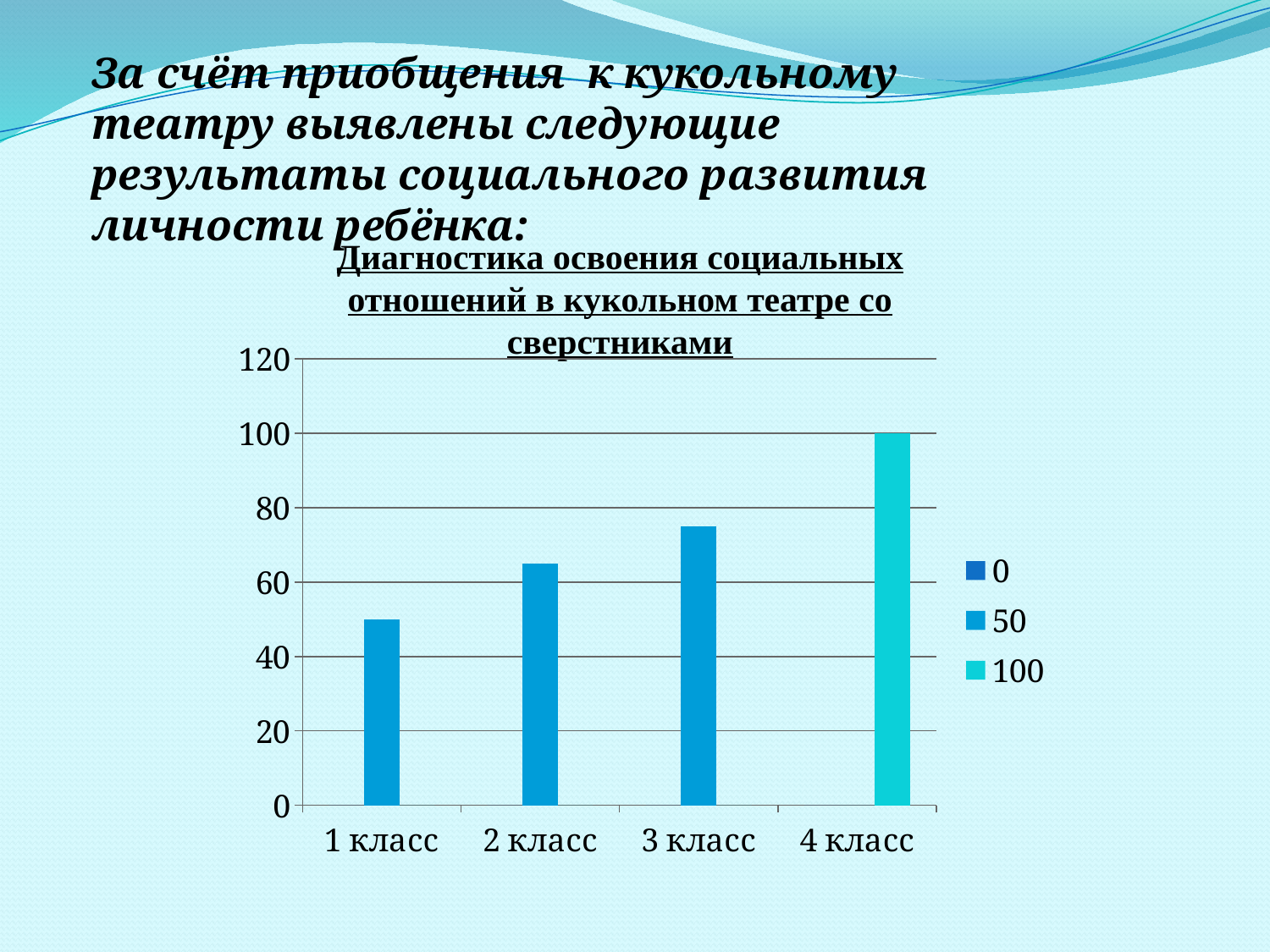
Is the value for 3 класс greater or less than 60? greater Is the value for 1 класс greater or less than 60? less Which category has the lowest bar in the chart? 1 класс How many entries does the chart's legend list? 3 Which has the larger value, 2 класс or 3 класс? 3 класс Is the value for 2 класс greater or less than 80? less Which category has the highest bar in the chart? 4 класс What is the value for 4 класс in the chart? 100 How many categories are shown on the x axis of the chart? 4 Do the values rise or fall from 1 класс to 4 класс? rise What kind of chart is shown on the slide? bar chart What is the title of the chart? Диагностика освоения социальных отношений в кукольном театре со сверстниками